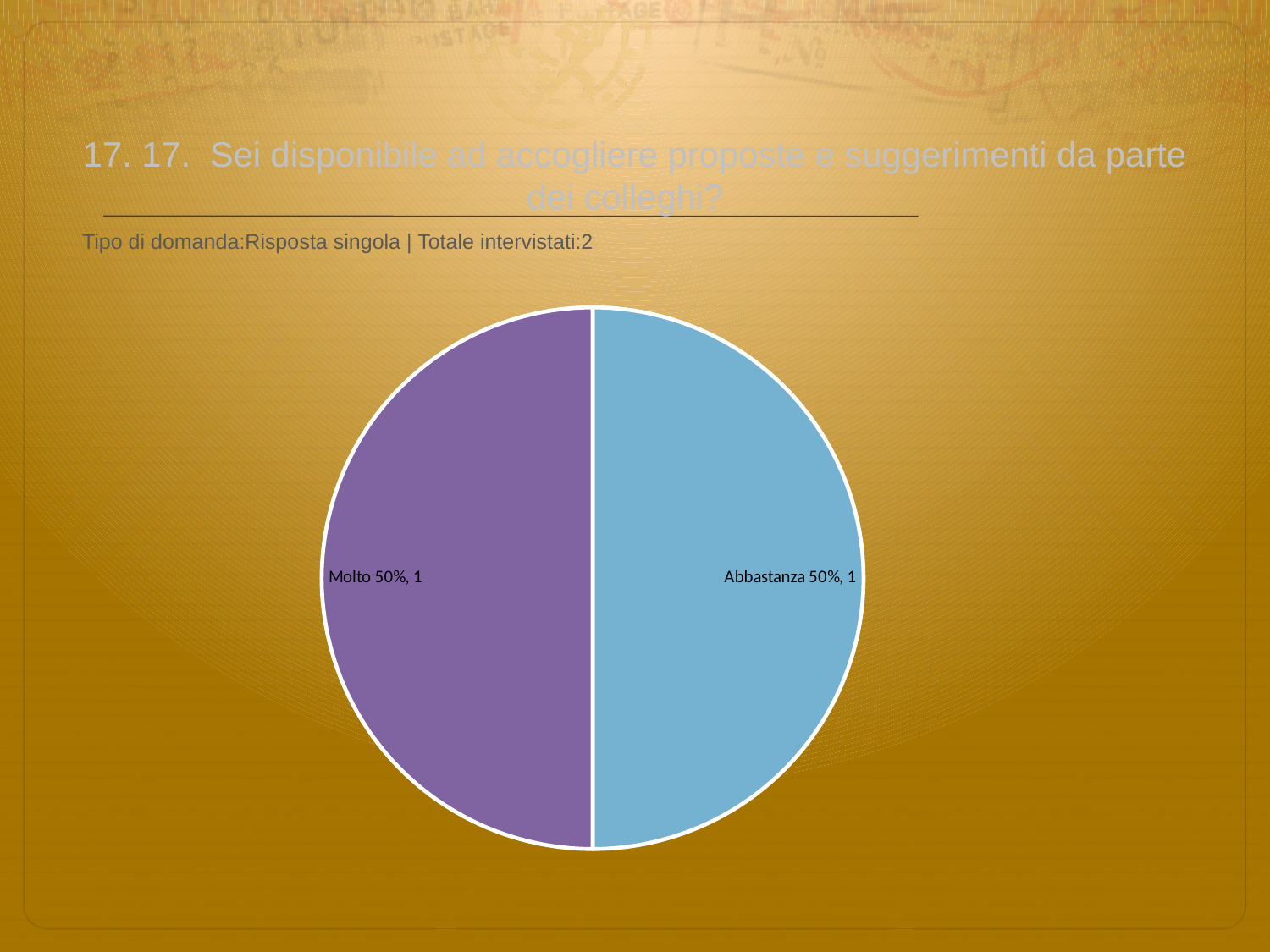
What share of the pie does the Molto slice represent? 50% What is the count value shown for the Abbastanza slice? 1 What colour is the Abbastanza slice? light blue What is the count value shown for the Molto slice? 1 What colour is the Molto slice? purple How many slices does the pie chart have? 2 What is the total number of respondents across both slices? 2 What is the difference between the counts for Molto and Abbastanza? 0 What kind of chart is shown on the slide? pie chart What share of the pie does the Abbastanza slice represent? 50%